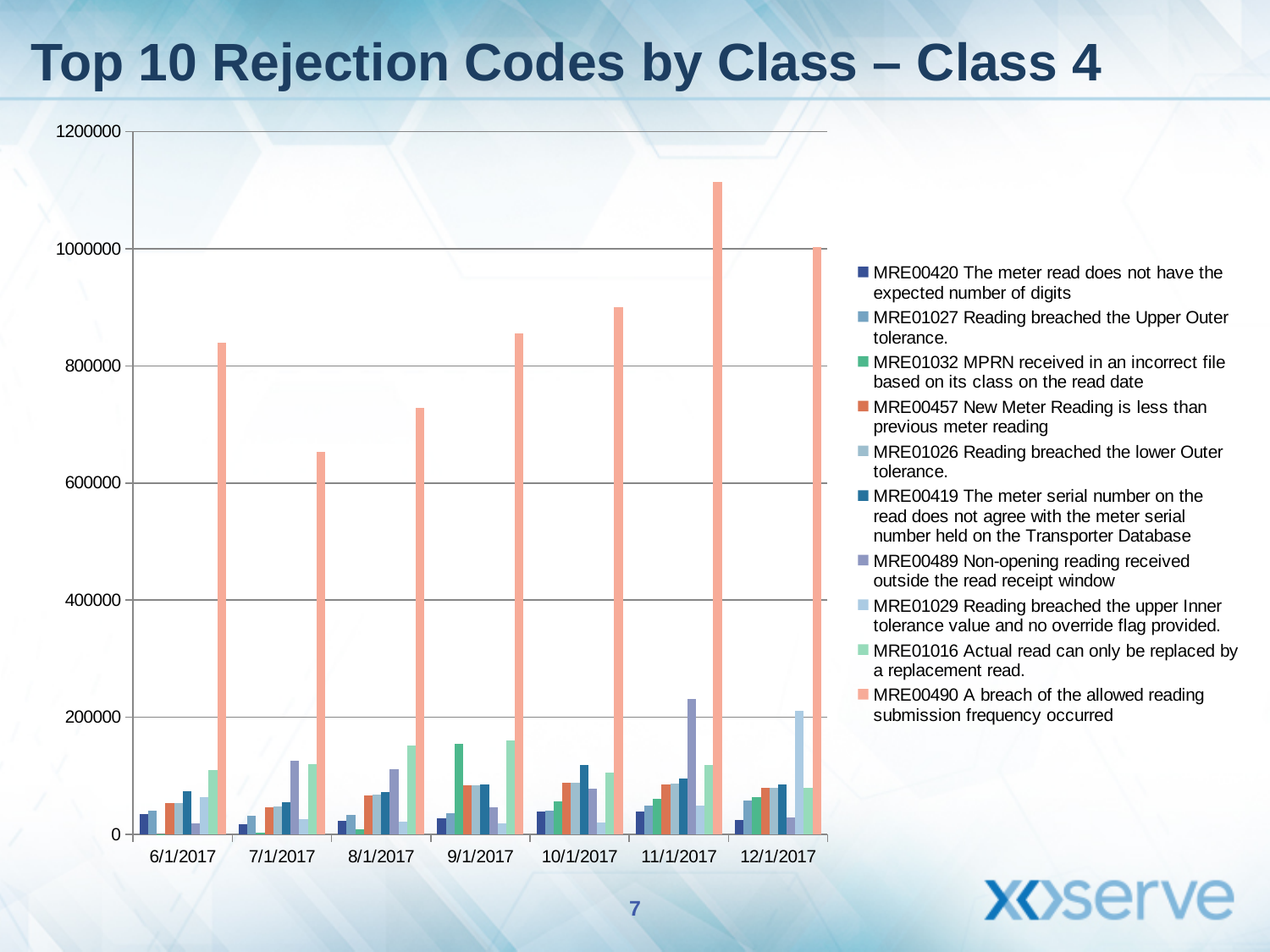
Which series in the legend is the last one listed? MRE00490 A breach of the allowed reading submission frequency occurred How many series does the chart's legend list? 10 On which date is the bar for MRE00490 A breach of the allowed reading submission frequency occurred the shortest? 7/1/2017 Is the value for MRE00490 on 11/1/2017 greater or less than 1000000? greater Is the value for MRE00490 on 7/1/2017 greater or less than 800000? less Is the value for MRE00489 Non-opening reading received outside the read receipt window on 11/1/2017 greater or less than 200000? greater On which date is the bar for MRE00490 A breach of the allowed reading submission frequency occurred the tallest? 11/1/2017 How many dates are shown along the x axis of the chart? 7 Which date has the larger value for MRE00490: 8/1/2017 or 7/1/2017? 8/1/2017 What is the title of the chart on the slide? Top 10 Rejection Codes by Class – Class 4 What kind of chart is shown on the slide? Bar chart